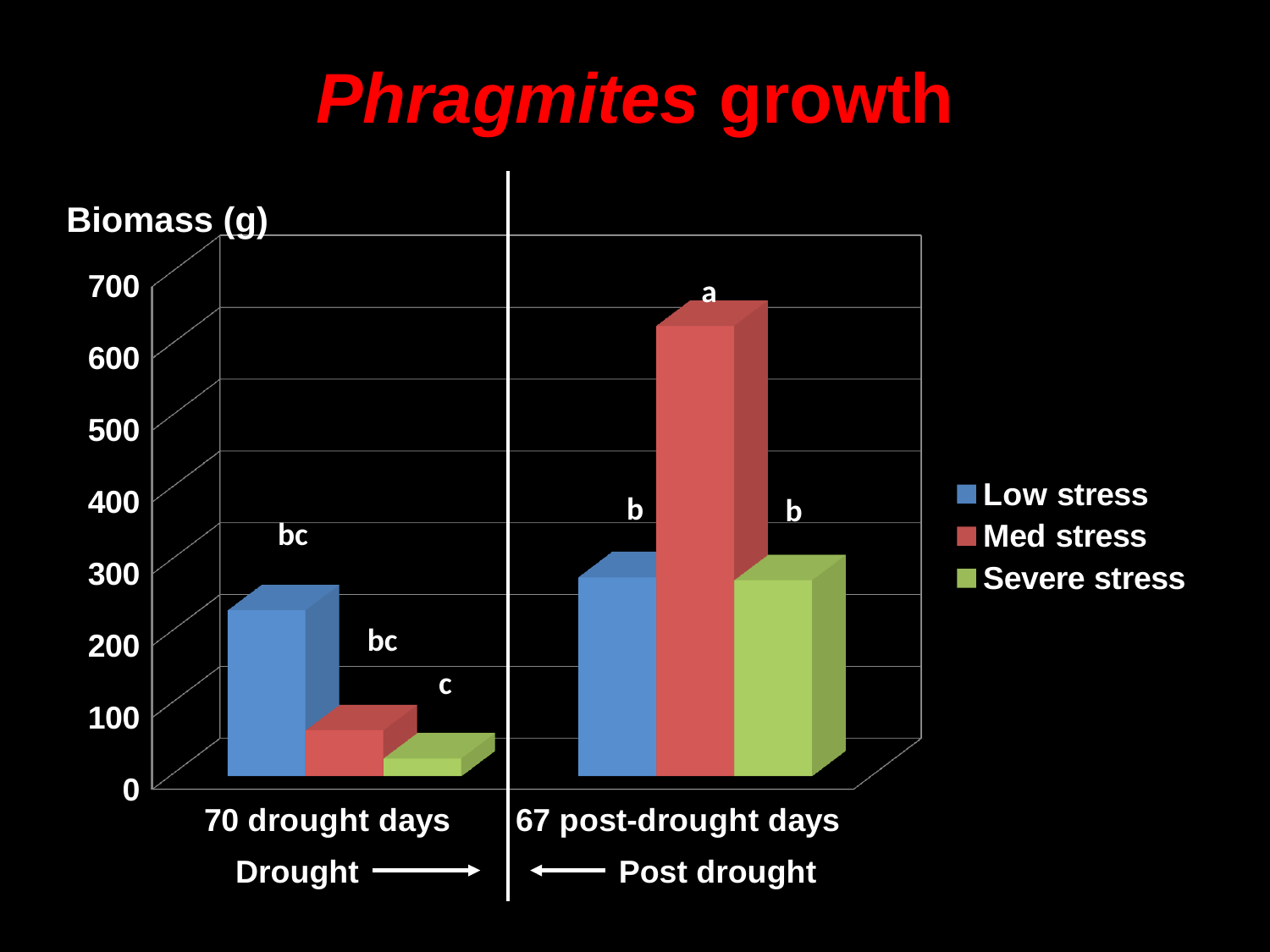
Which is larger for 70 drought days: Low stress or Med stress? Low stress What letter label is printed above the Med stress bar for 67 post-drought days? a Is the Severe stress value for 70 drought days greater or less than 100? less How many categories are shown on the x axis? 2 Does the Med stress biomass rise or fall from 70 drought days to 67 post-drought days? rise What is the title of the chart? Phragmites growth Which bar has the lowest biomass on the chart? Severe stress at 70 drought days Is the Med stress value for 67 post-drought days greater or less than 500? greater What kind of chart is shown on the slide? bar chart Is the Low stress value for 70 drought days greater or less than 300? less How many series does the legend list? 3 Which bar has the highest biomass on the chart? Med stress at 67 post-drought days